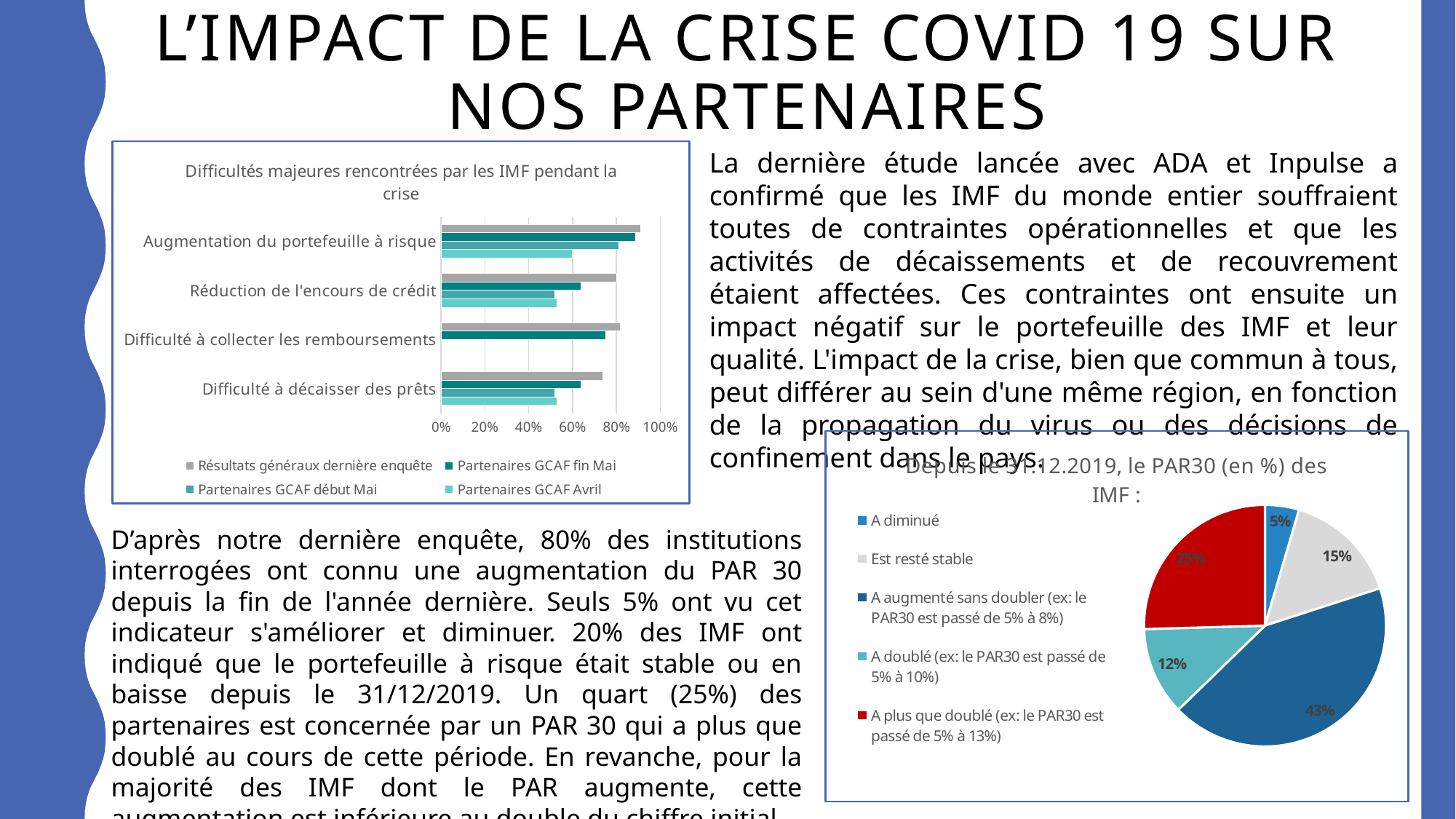
In the chart "Difficultés majeures rencontrées par les IMF pendant la crise", is the value of "Partenaires GCAF Avril" for "Augmentation du portefeuille à risque" greater or less than 80%? less How many series does the legend of the chart "Difficultés majeures rencontrées par les IMF pendant la crise" list? 4 In the pie chart "Depuis le 31.12.2019, le PAR30 (en %) des IMF :", what is the difference between the share for "A augmenté sans doubler" and the share for "A plus que doublé"? 18% In the chart "Difficultés majeures rencontrées par les IMF pendant la crise", is the value of "Partenaires GCAF fin Mai" for "Difficulté à collecter les remboursements" greater or less than 60%? greater In the pie chart "Depuis le 31.12.2019, le PAR30 (en %) des IMF :", which category has the largest slice? A augmenté sans doubler (ex: le PAR30 est passé de 5% à 8%) What kind of chart is the chart titled "Depuis le 31.12.2019, le PAR30 (en %) des IMF :"? pie chart In the chart "Difficultés majeures rencontrées par les IMF pendant la crise", is the value of "Résultats généraux dernière enquête" for "Augmentation du portefeuille à risque" greater or less than 80%? greater How many slices does the pie chart "Depuis le 31.12.2019, le PAR30 (en %) des IMF :" have? 5 What kind of chart is the chart titled "Difficultés majeures rencontrées par les IMF pendant la crise"? bar chart How many categories are shown in the chart "Difficultés majeures rencontrées par les IMF pendant la crise"? 4 In the pie chart "Depuis le 31.12.2019, le PAR30 (en %) des IMF :", what share is shown for "A doublé (ex: le PAR30 est passé de 5% à 10%)"? 12% In the pie chart "Depuis le 31.12.2019, le PAR30 (en %) des IMF :", what share is shown for "A diminué"? 5%